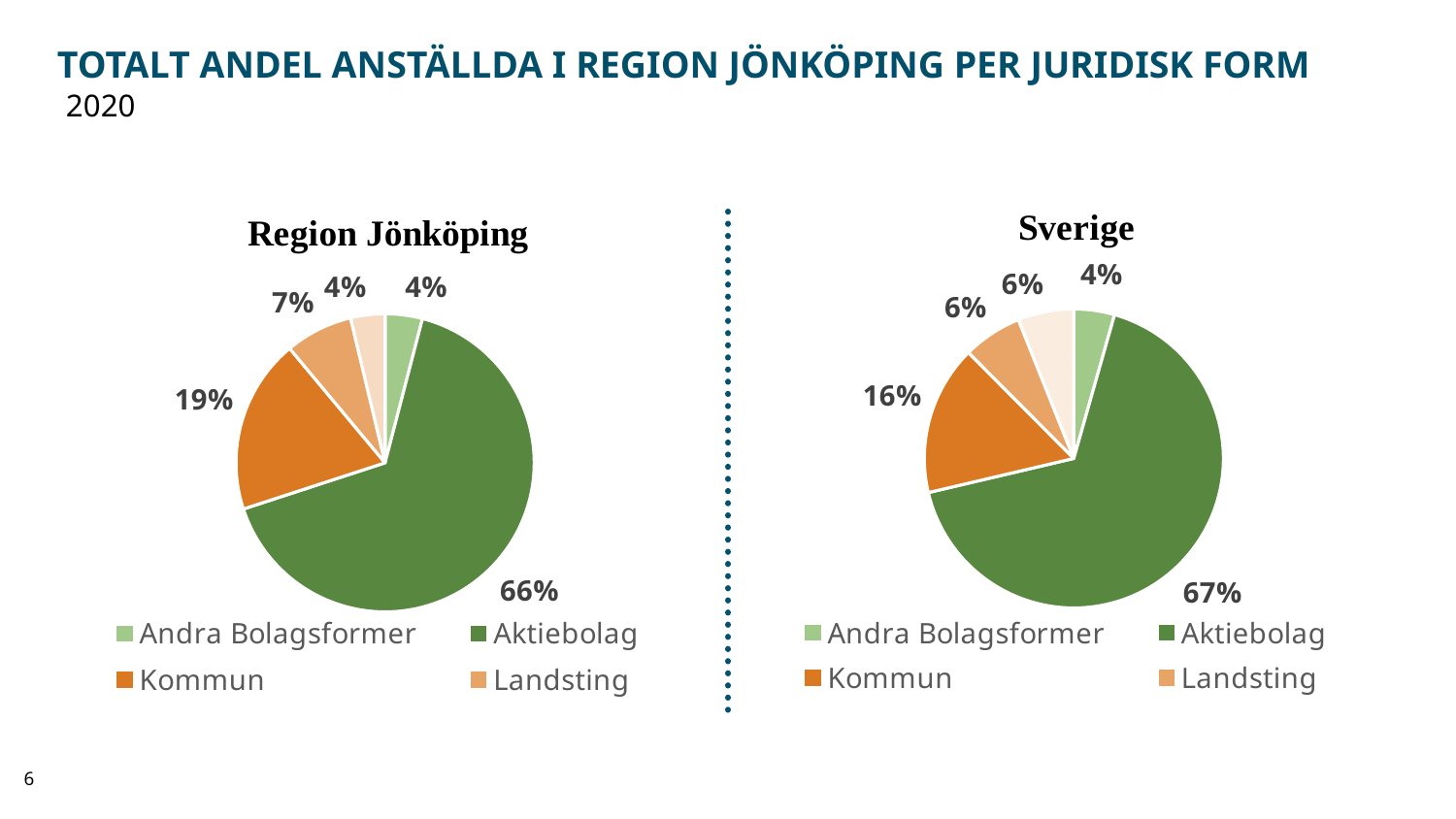
In the Sverige pie chart, what share does Andra Bolagsformer have? 4% How many entries does the legend of the Sverige chart list? 4 What is the difference between the Kommun share in the Region Jönköping chart and the Kommun share in the Sverige chart? 3 percentage points In the Region Jönköping pie chart, which category has the largest share? Aktiebolag In the Sverige pie chart, what share does Kommun have? 16% In the Region Jönköping pie chart, what share does Kommun have? 19% In the Sverige pie chart, what share does Aktiebolag have? 67% What type of chart is used for Region Jönköping and Sverige on this slide? Pie chart In the Region Jönköping pie chart, what share does Landsting have? 7% Is the Kommun share larger in the Region Jönköping chart or in the Sverige chart? Region Jönköping In the Region Jönköping pie chart, what share does Aktiebolag have? 66% In the Sverige pie chart, which category has the largest share? Aktiebolag